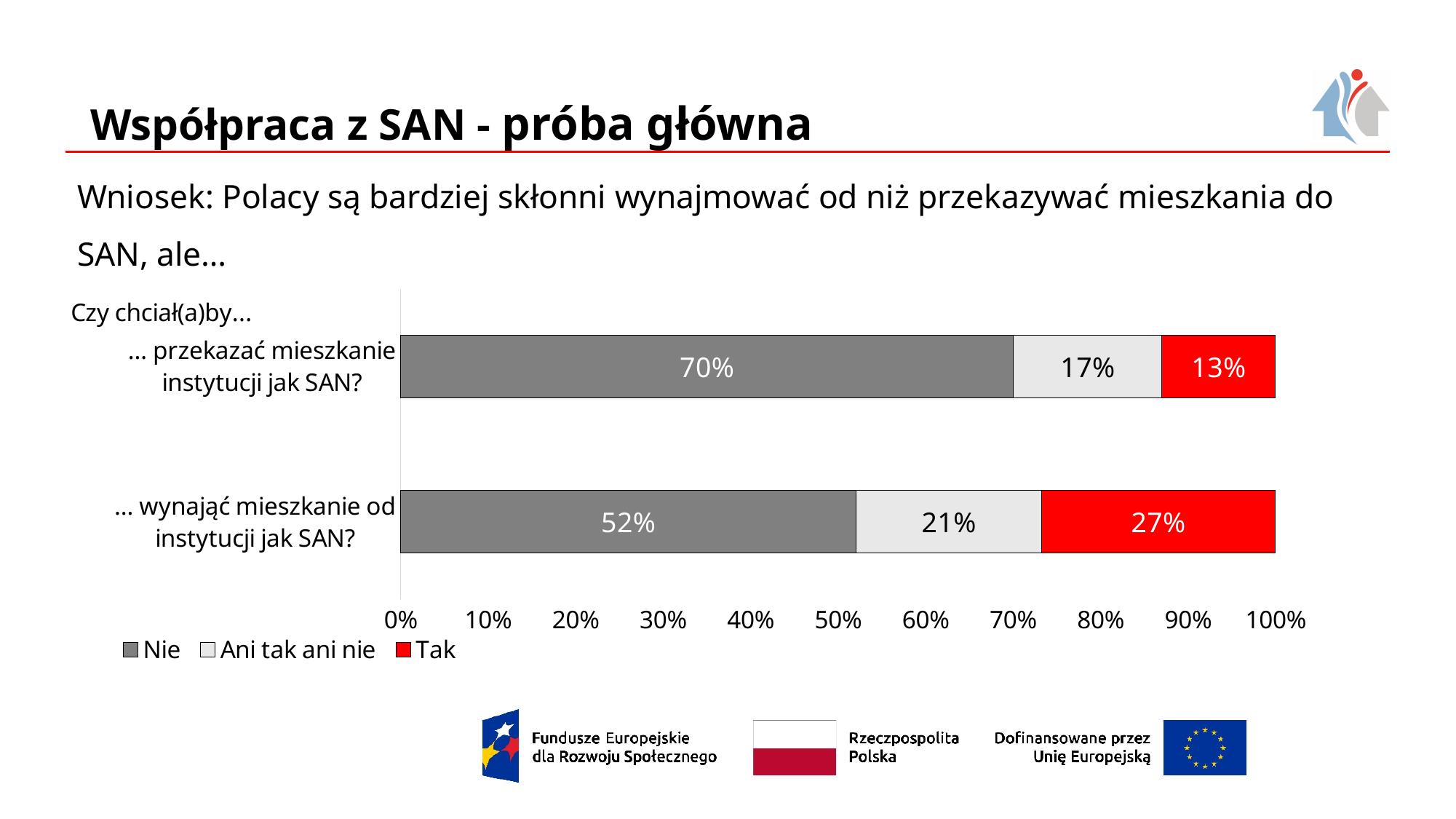
How many questions (categories) are shown in the chart? 2 What kind of chart is shown on the slide? Stacked horizontal bar chart What is the difference in the "Tak" share between "... wynająć mieszkanie od instytucji jak SAN?" and "... przekazać mieszkanie instytucji jak SAN?"? 14 percentage points What percentage answered "Tak" to "... wynająć mieszkanie od instytucji jak SAN?"? 27% What percentage answered "Ani tak ani nie" to "... przekazać mieszkanie instytucji jak SAN?"? 17% What percentage answered "Nie" to "... wynająć mieszkanie od instytucji jak SAN?"? 52% Which colour represents the "Tak" series in the chart? Red What is the total of the stacked bar for "... wynająć mieszkanie od instytucji jak SAN?"? 100% What is the difference in the "Nie" share between "... przekazać mieszkanie instytucji jak SAN?" and "... wynająć mieszkanie od instytucji jak SAN?"? 18 percentage points How many series does the legend list? 3 Which question has the higher "Tak" share: "... przekazać mieszkanie instytucji jak SAN?" or "... wynająć mieszkanie od instytucji jak SAN?"? ... wynająć mieszkanie od instytucji jak SAN? What percentage answered "Nie" to "... przekazać mieszkanie instytucji jak SAN?"? 70%